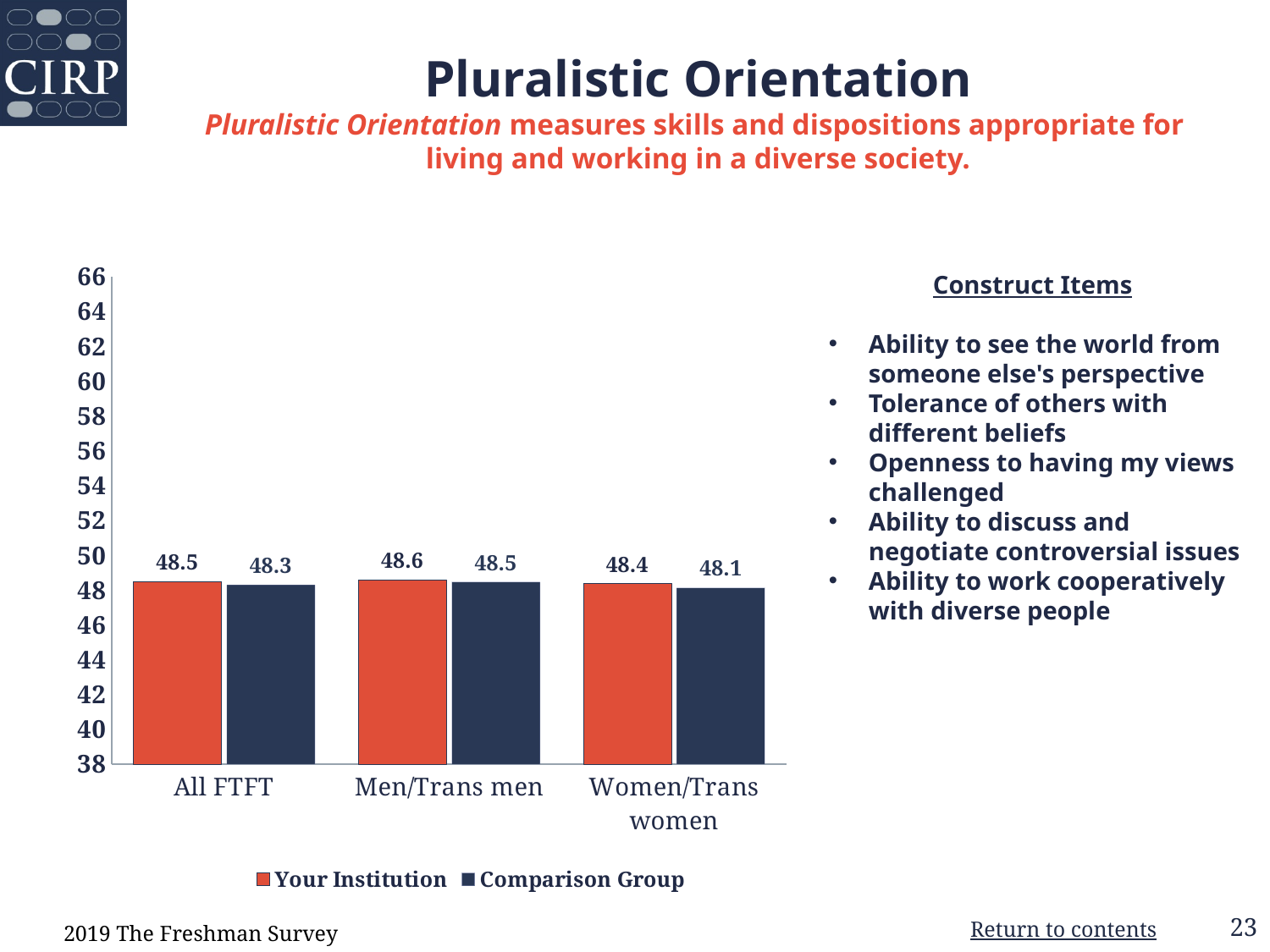
Which category has the lowest value for Comparison Group? Women/Trans women What is the value for Comparison Group in the Men/Trans men category? 48.5 What is the difference between Your Institution and Comparison Group in the Women/Trans women category? 0.3 What is the value for Your Institution in the Women/Trans women category? 48.4 What is the value for Your Institution in the All FTFT category? 48.5 How many categories are shown on the x axis? 3 Which is larger in the All FTFT category, Your Institution or Comparison Group? Your Institution Which series is shown in dark blue in the legend? Comparison Group Which category has the highest value for Your Institution? Men/Trans men What is the value for Comparison Group in the Women/Trans women category? 48.1 What kind of chart is shown on the slide? Bar chart How many series does the legend list? 2